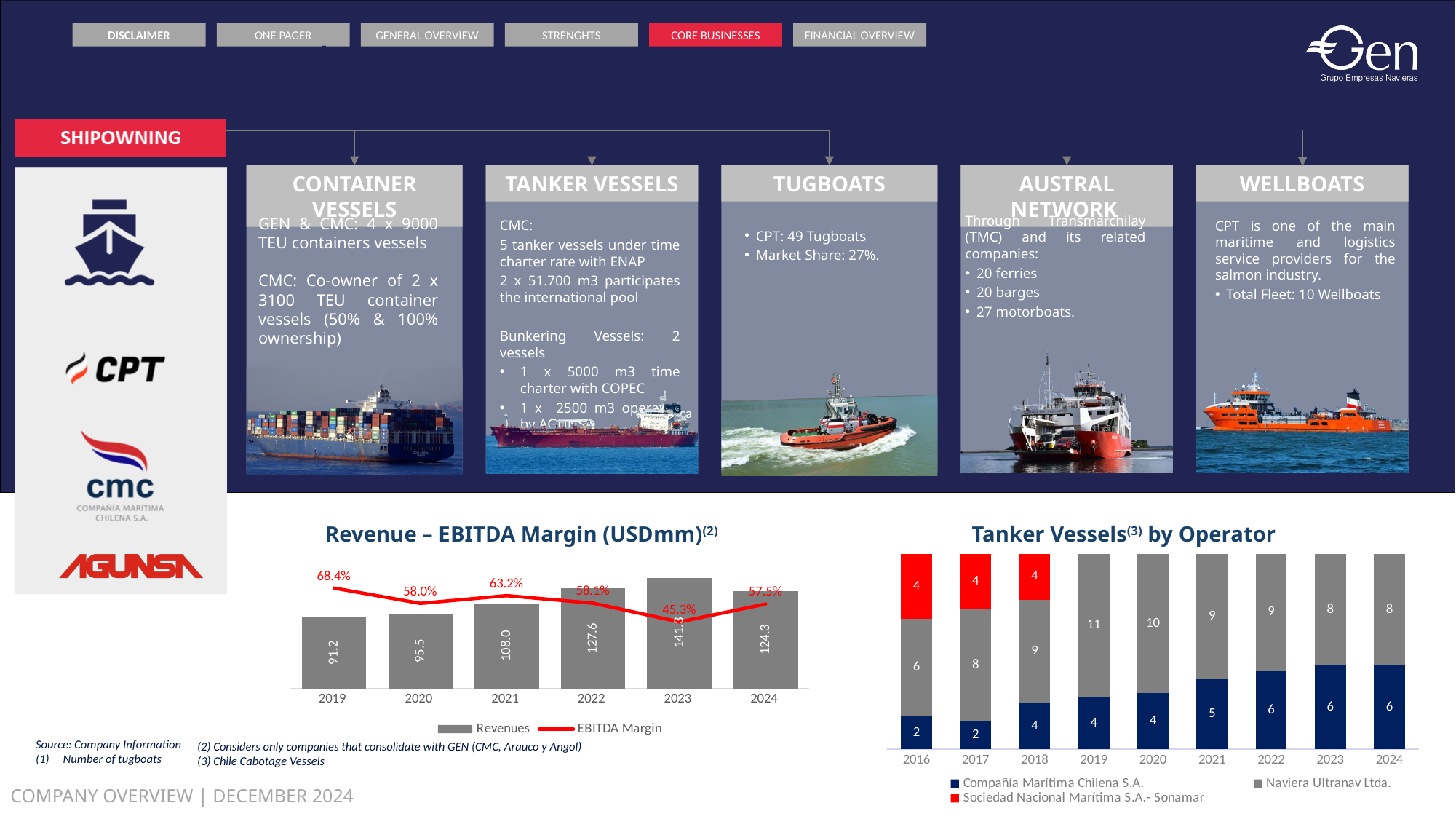
In the Revenue – EBITDA Margin chart, which year had the lowest EBITDA margin? 2023 In the Revenue – EBITDA Margin chart, how many series does the legend list? 2 In the Tanker Vessels by Operator chart, what is the total number of tanker vessels in 2018? 17 In the Revenue – EBITDA Margin chart, which year had the highest revenue? 2023 In the Tanker Vessels by Operator chart, how many vessels did Naviera Ultranav Ltda. have in 2019? 11 In the Revenue – EBITDA Margin chart, how many years are shown on the x axis? 6 In the Tanker Vessels by Operator chart, which is larger in 2024: Compañía Marítima Chilena S.A. or Naviera Ultranav Ltda.? Naviera Ultranav Ltda. In the Revenue – EBITDA Margin chart, what was the revenue in 2023? 141.3 What type of chart is the Tanker Vessels by Operator chart? Stacked bar chart In the Revenue – EBITDA Margin chart, what was the EBITDA margin in 2019? 68.4% In the Revenue – EBITDA Margin chart, what is the difference between the 2022 and 2021 revenues? 19.6 In the Tanker Vessels by Operator chart, how many series does the legend list? 3